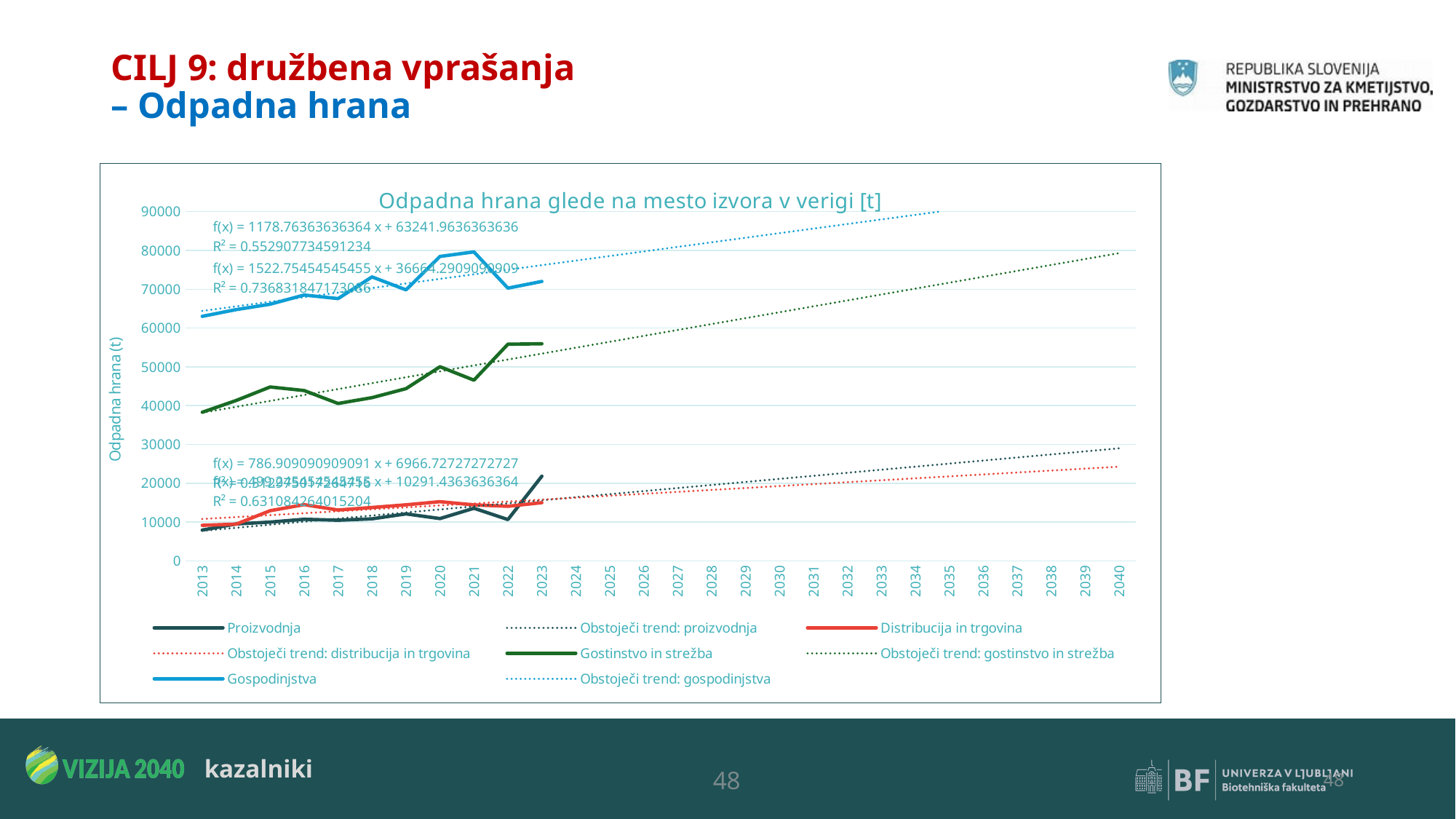
Is the value for Gospodinjstva in 2013 greater or less than 60000? greater What kind of chart is shown on the slide? line chart How many series does the chart legend list? 8 What is the title of the chart? Odpadna hrana glede na mesto izvora v verigi [t] Does the Gostinstvo in strežba series overall rise or fall from 2013 to 2023? rise Which is larger in 2023, the value for Gostinstvo in strežba or the value for Gospodinjstva? Gospodinjstva Which series has the highest values throughout the chart? Gospodinjstva What is the R² value printed for the trend line with the equation f(x) = 1178.76363636364 x + 63241.9636363636? 0.552907734591234 Is the value for Gostinstvo in strežba in 2023 greater or less than 50000? greater How many year labels are shown on the x axis? 28 Is the value for Proizvodnja in 2022 greater or less than 20000? less Which series has the lowest value in 2022? Proizvodnja